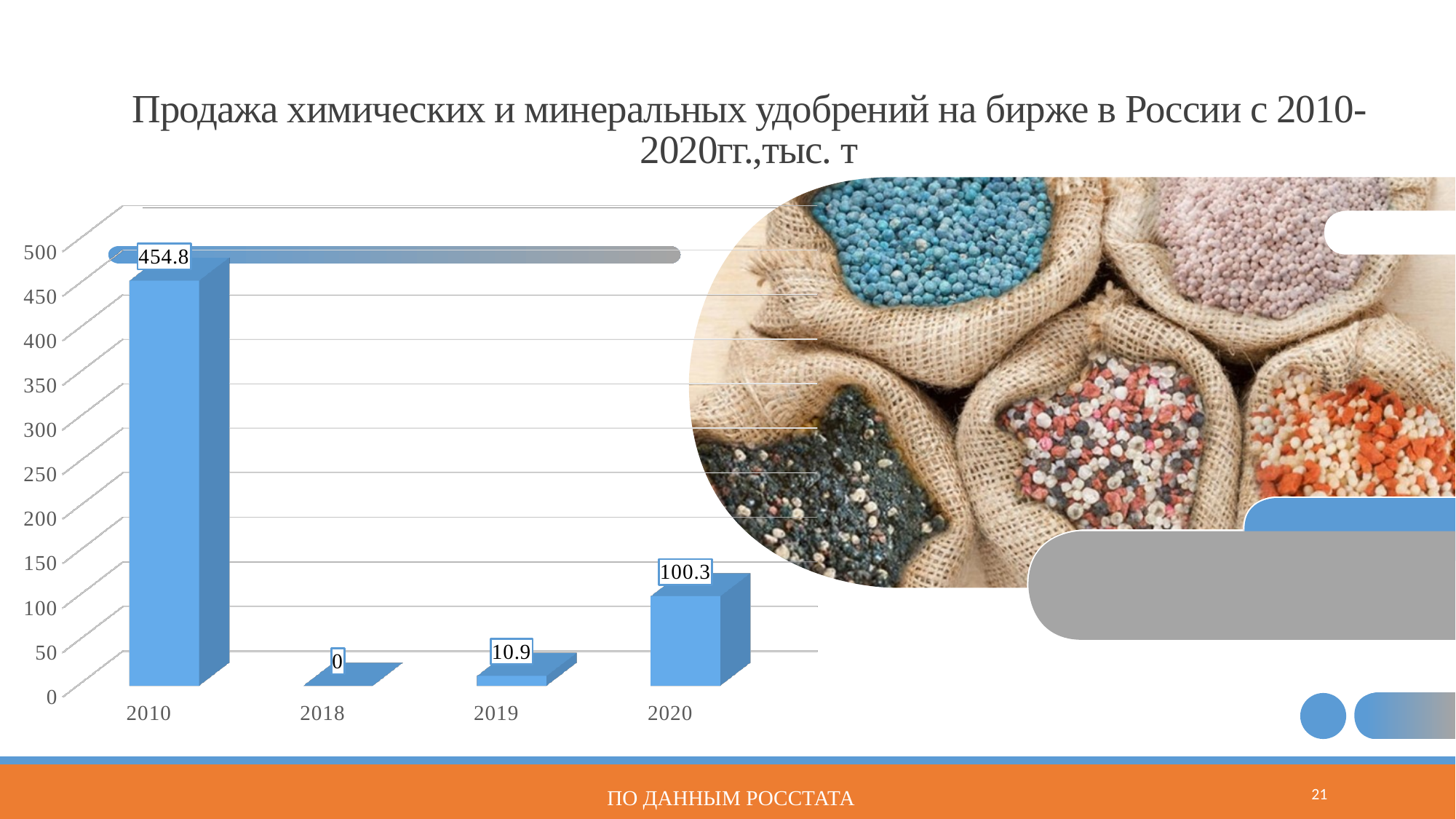
What is the value for 2018? 0 What is the value for 2010? 454.8 What is the value for 2019? 10.9 What is the title of the chart? Продажа химических и минеральных удобрений на бирже в России с 2010-2020гг.,тыс. т How many years are shown on the x axis? 4 Which is larger, the value for 2019 or the value for 2020? 2020 What is the value for 2020? 100.3 What kind of chart is shown on the slide? bar chart Which year has the lowest value? 2018 What is the difference between the values for 2020 and 2019? 89.4 What is the difference between the values for 2010 and 2020? 354.5 Which year has the highest value? 2010